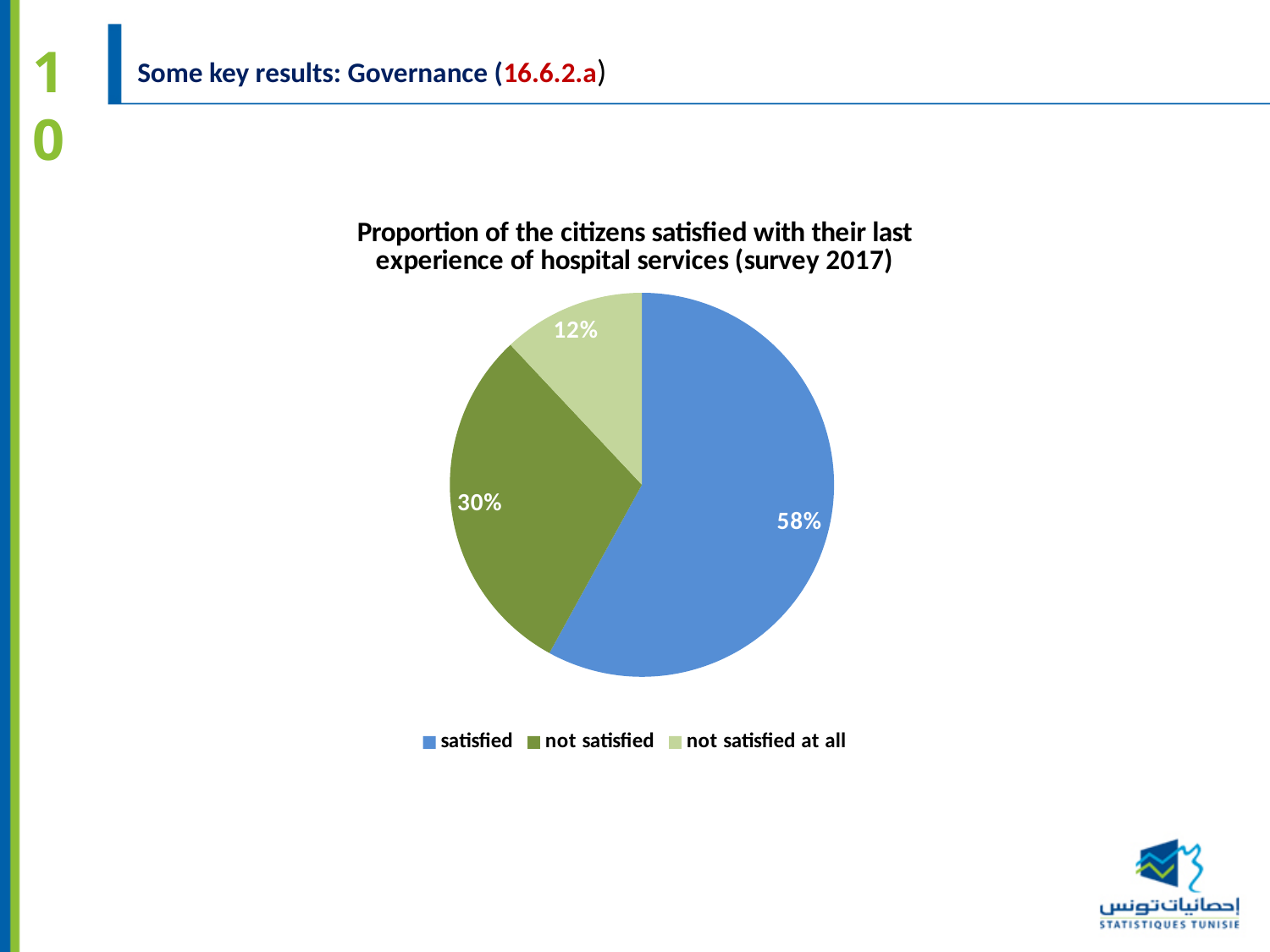
What type of chart is shown on the slide? pie chart Which is larger, the share for not satisfied or the share for not satisfied at all? not satisfied What percentage of citizens were not satisfied at all? 12% What is the difference in percentage points between the satisfied and not satisfied shares? 28 Which category has the largest share of the pie? satisfied What colour is the slice for satisfied? blue Which category has the smallest share of the pie? not satisfied at all What percentage of citizens were satisfied with their last experience of hospital services? 58% What percentage of citizens were not satisfied? 30% What is the title of the chart? Proportion of the citizens satisfied with their last experience of hospital services (survey 2017) What is the difference in percentage points between the not satisfied and not satisfied at all shares? 18 How many categories does the pie chart show? 3